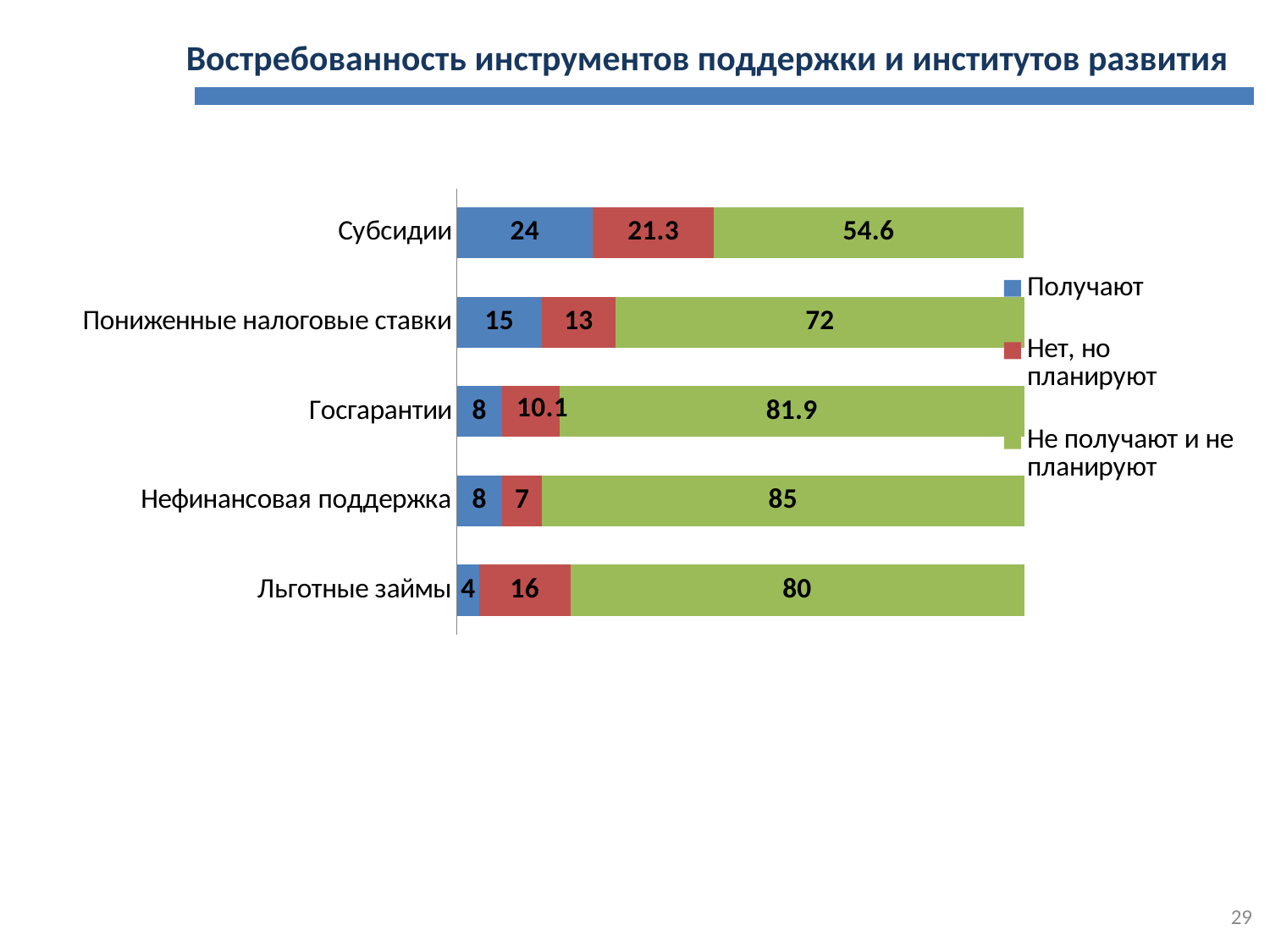
What is the value of 'Получают' for 'Субсидии'? 24 What is the total of the stacked bar for 'Пониженные налоговые ставки'? 100 Which category has the highest value for 'Получают'? Субсидии What is the value of 'Не получают и не планируют' for 'Нефинансовая поддержка'? 85 How many series does the legend list? 3 How many categories are shown in the chart? 5 Which is larger: the 'Нет, но планируют' value for 'Льготные займы' or for 'Пониженные налоговые ставки'? Льготные займы What type of chart is shown on the slide? Stacked bar chart Which category has the lowest value for 'Не получают и не планируют'? Субсидии Which category has the lowest value for 'Получают'? Льготные займы What is the value of 'Нет, но планируют' for 'Госгарантии'? 10.1 What is the difference between the 'Не получают и не планируют' values for 'Нефинансовая поддержка' and 'Пониженные налоговые ставки'? 13